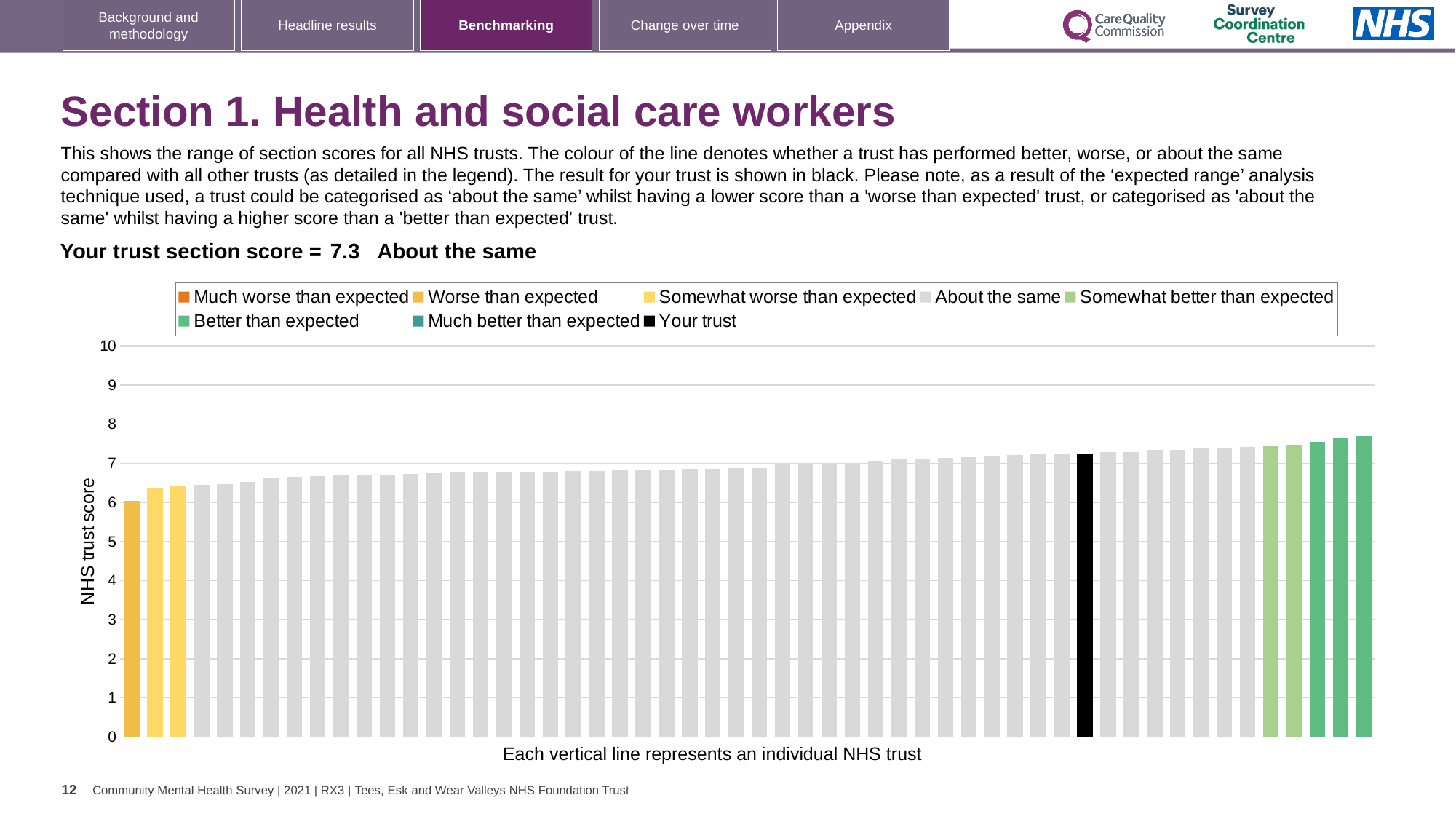
Do the bar values rise or fall from left to right along the x axis? Rise Is the value of the highest bar greater or less than 8? less Which performance category is your trust placed in? About the same What is the highest value shown on the vertical axis? 10 How many bars are shown in a green shade at the right end of the chart? 5 How many entries does the legend list? 8 What kind of chart is shown on the slide? Bar chart Is the value of the lowest bar greater or less than 7? less What is the label on the vertical axis? NHS trust score Is the value for your trust (the black bar) greater or less than 7? greater What is the section score for your trust? 7.3 How many bars are coloured black? 1